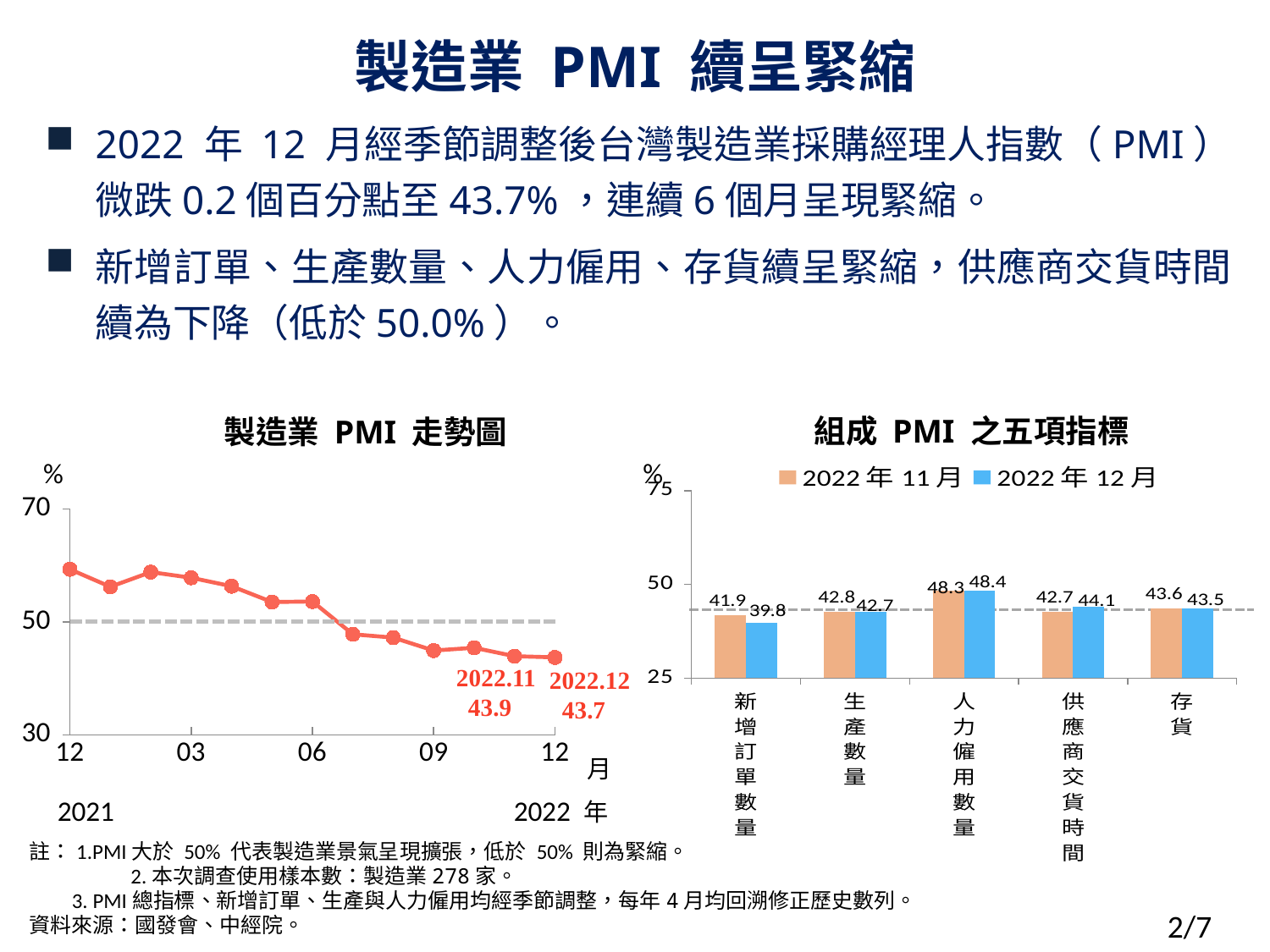
In the chart titled 組成 PMI 之五項指標, what is the 2022 年 11 月 value for 供應商交貨時間? 42.7 In the chart titled 組成 PMI 之五項指標, what is the difference between the 2022 年 11 月 and 2022 年 12 月 values for 新增訂單數量? 2.1 In the chart titled 組成 PMI 之五項指標, how many categories are shown on the x axis? 5 In the chart titled 製造業 PMI 走勢圖, what is the PMI value for 2022.11? 43.9 In the chart titled 製造業 PMI 走勢圖, what kind of chart is shown? line chart In the chart titled 製造業 PMI 走勢圖, is the value at 03 (2022) greater or less than 50? greater In the chart titled 組成 PMI 之五項指標, what is the 2022 年 12 月 value for 新增訂單數量? 39.8 In the chart titled 製造業 PMI 走勢圖, what is the PMI value for 2022.12? 43.7 In the chart titled 組成 PMI 之五項指標, how many series does the legend list? 2 In the chart titled 組成 PMI 之五項指標, which category has the lowest 2022 年 12 月 value? 新增訂單數量 In the chart titled 製造業 PMI 走勢圖, do the values generally rise or fall from 12 (2021) to 12 (2022)? fall In the chart titled 組成 PMI 之五項指標, which category has the highest 2022 年 12 月 value? 人力僱用數量